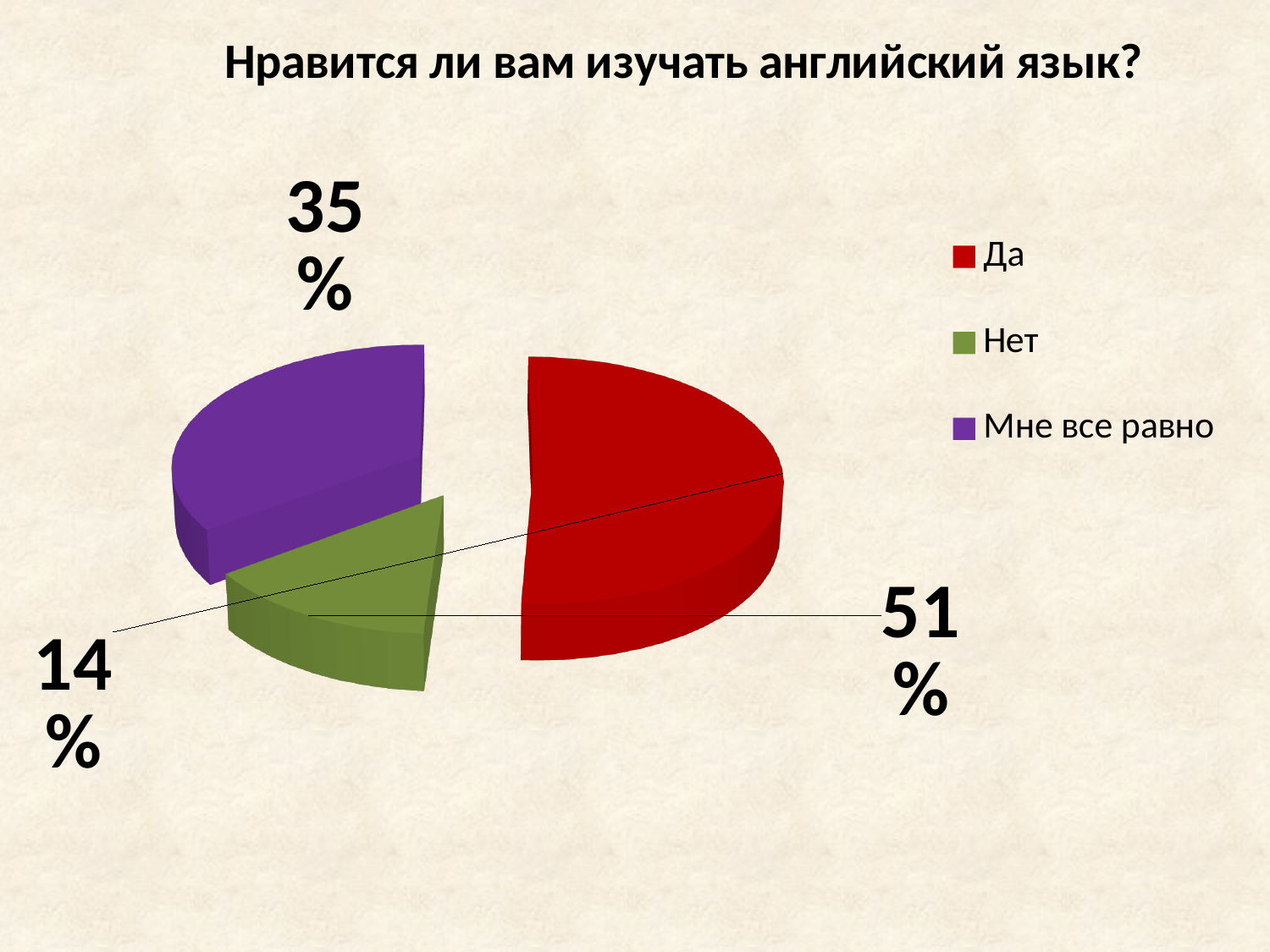
What colour is the slice for "Мне все равно"? Purple What percentage of respondents answered "Нет"? 14% Which answer has the smallest share of the pie? Нет Which is larger, the share for "Нет" or the share for "Мне все равно"? Мне все равно How many entries does the legend list? 3 What percentage of respondents answered "Да"? 51% How many categories does the pie chart show? 3 What is the difference in percentage points between "Да" and "Мне все равно"? 16 What percentage of respondents answered "Мне все равно"? 35% Which answer has the largest share of the pie? Да What is the title of the chart? Нравится ли вам изучать английский язык? What type of chart is shown on the slide? Pie chart